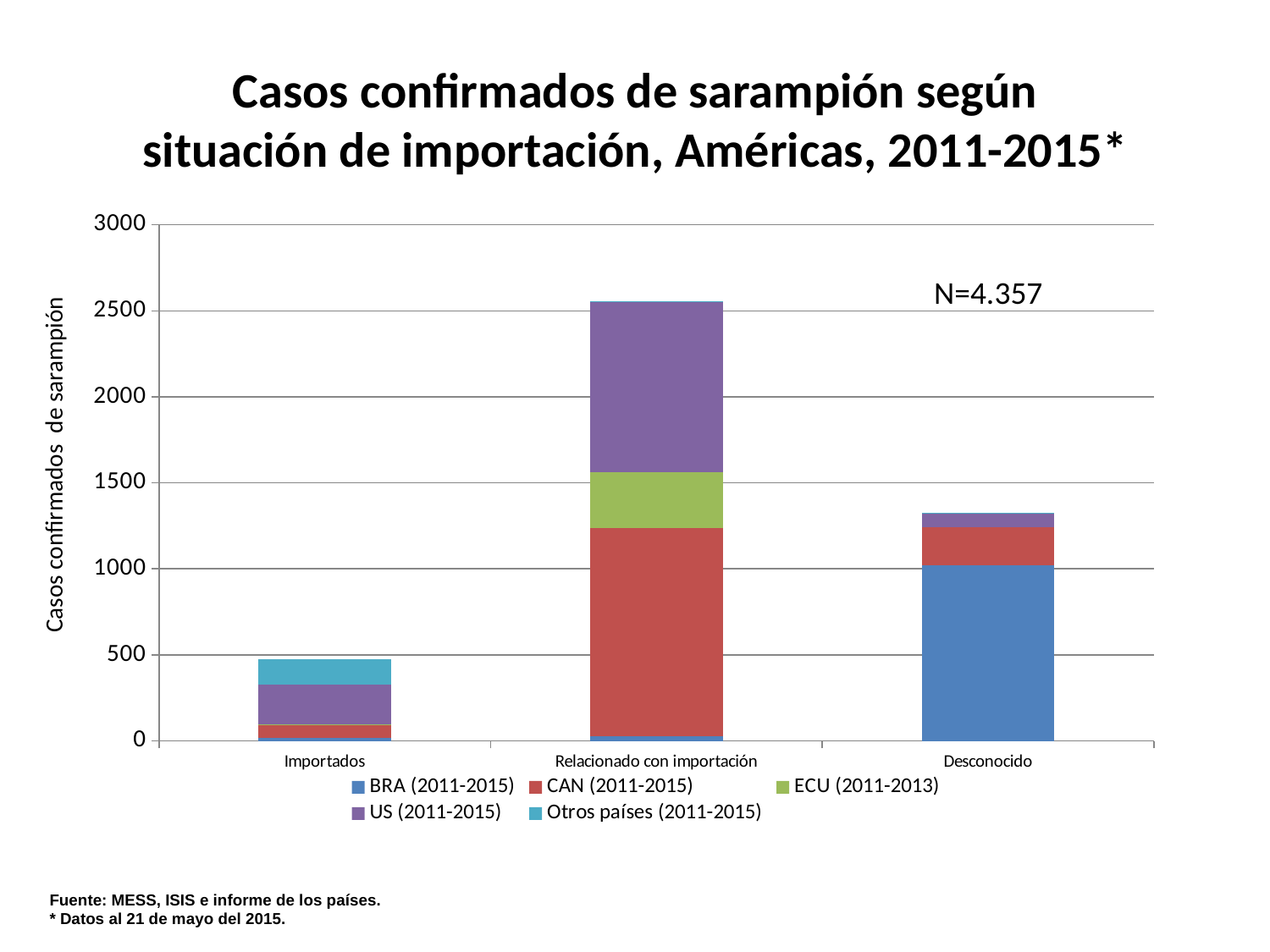
Is the total for Relacionado con importación greater or less than 2500? greater Which legend series covers only the years 2011-2013? ECU (2011-2013) How many series does the legend list? 5 What total N is annotated on the chart? N=4.357 Which category has the tallest stacked bar? Relacionado con importación Is the total for Desconocido greater or less than 1000? greater What kind of chart is shown on the slide? Stacked bar chart Is the total for Desconocido greater or less than 1500? less Which category has the shortest stacked bar? Importados Which stacked bar is taller, Desconocido or Importados? Desconocido How many categories are shown on the x axis? 3